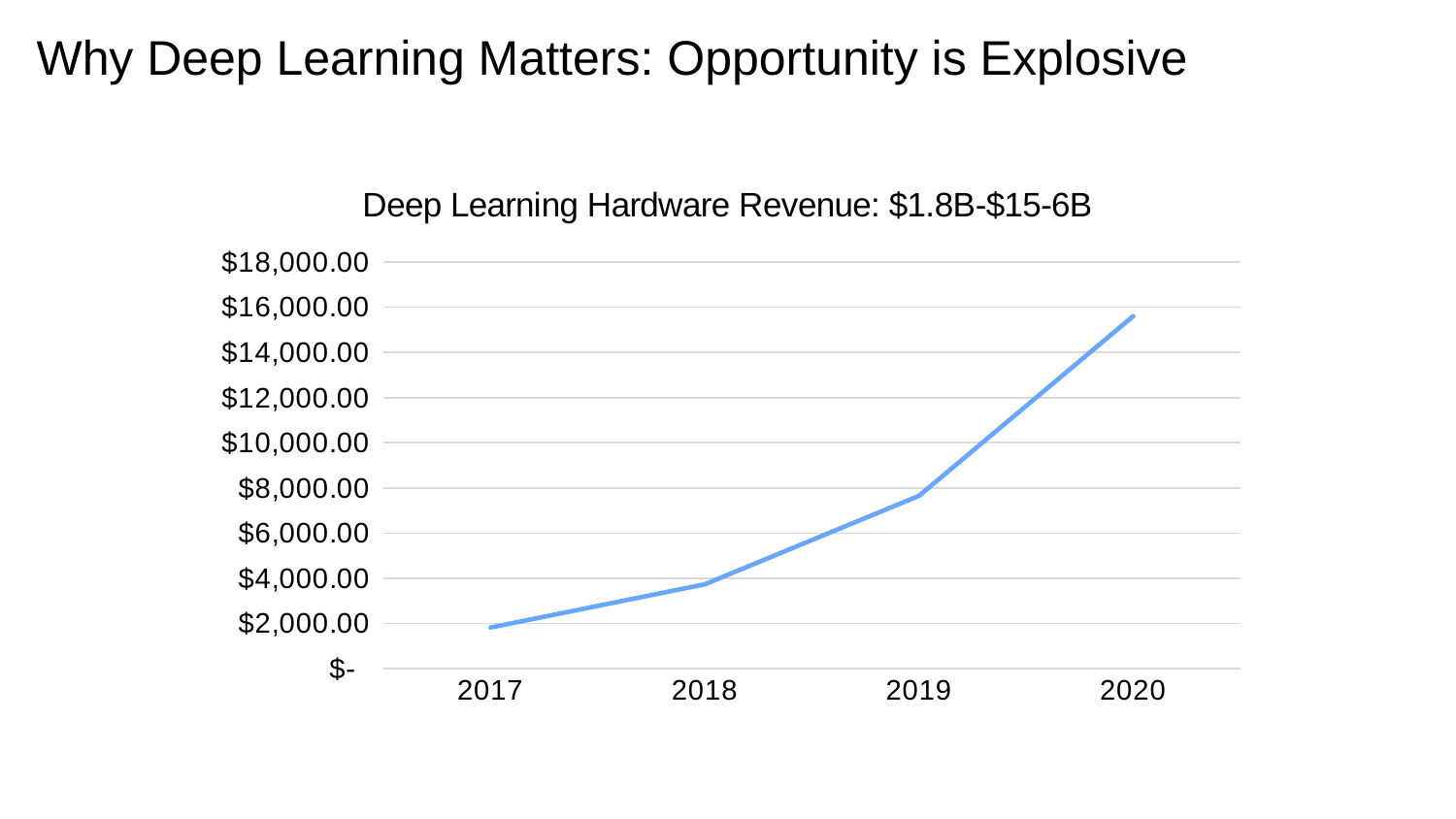
Is the value for 2018 greater or less than $4,000.00? less Which is larger, the value for 2019 or the value for 2018? 2019 Is the value for 2019 greater or less than $8,000.00? less How many years are plotted on the x axis of the chart? 4 What kind of chart is shown on the slide? line chart Is the value for 2020 greater or less than $14,000.00? greater Do the values rise or fall from 2017 to 2020? rise What is the title of the chart? Deep Learning Hardware Revenue: $1.8B-$15-6B Which year has the lowest value in the chart? 2017 What is the highest tick label shown on the y axis? $18,000.00 Which year has the highest value in the chart? 2020